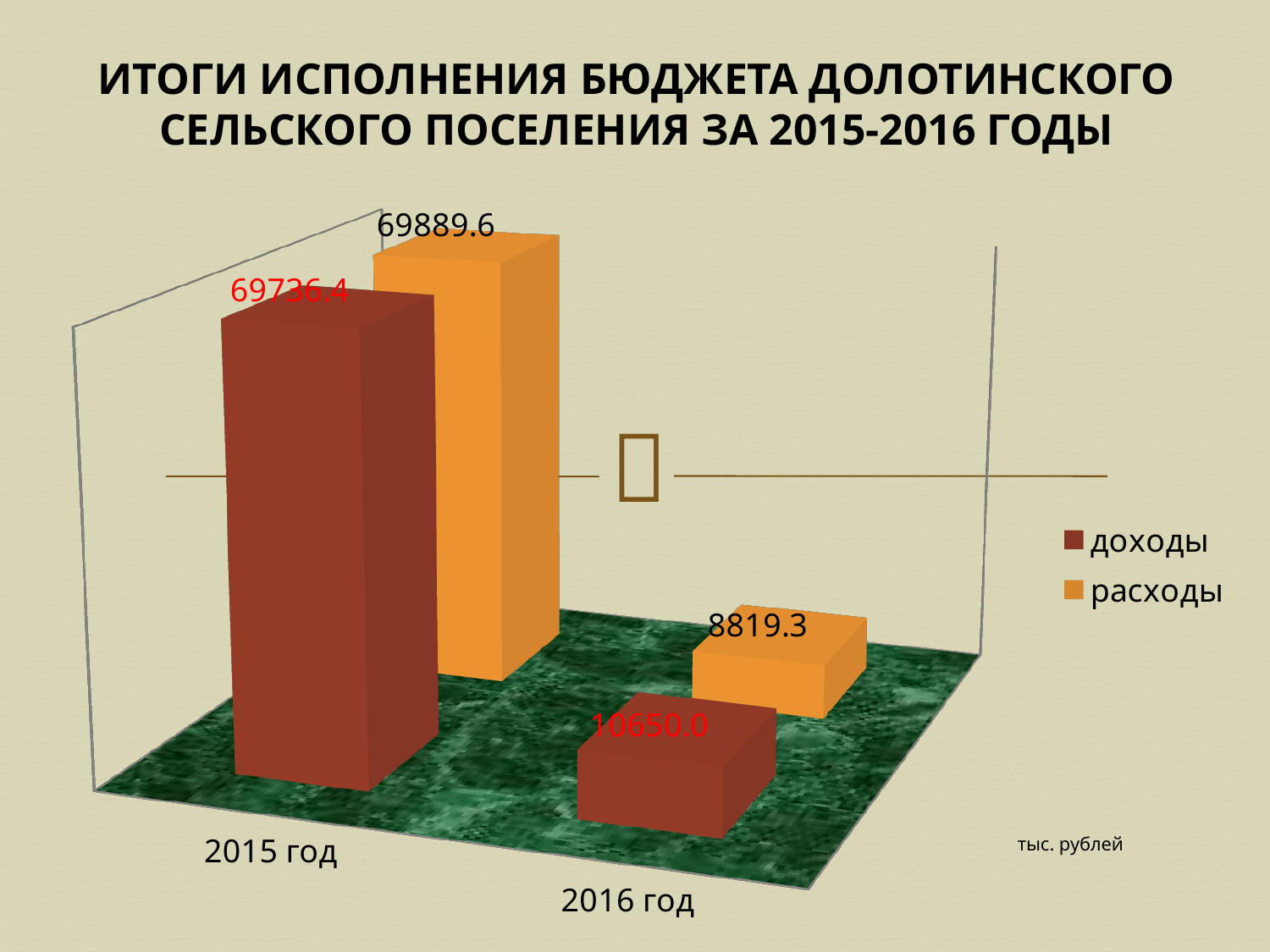
What is the value for расходы in 2015 год? 69889.6 What is the value for доходы in 2016 год? 10650.0 What is the difference between доходы and расходы in 2016 год? 1830.7 What unit of measurement is indicated on the chart? тыс. рублей In 2016 год, which is larger: доходы or расходы? доходы Which year has the lowest value for расходы? 2016 год What is the value for расходы in 2016 год? 8819.3 What kind of chart is shown on the slide? bar chart Which year has the higher value for доходы? 2015 год How many series does the legend list? 2 What is the difference between доходы in 2015 год and доходы in 2016 год? 59086.4 What is the value for доходы in 2015 год? 69736.4